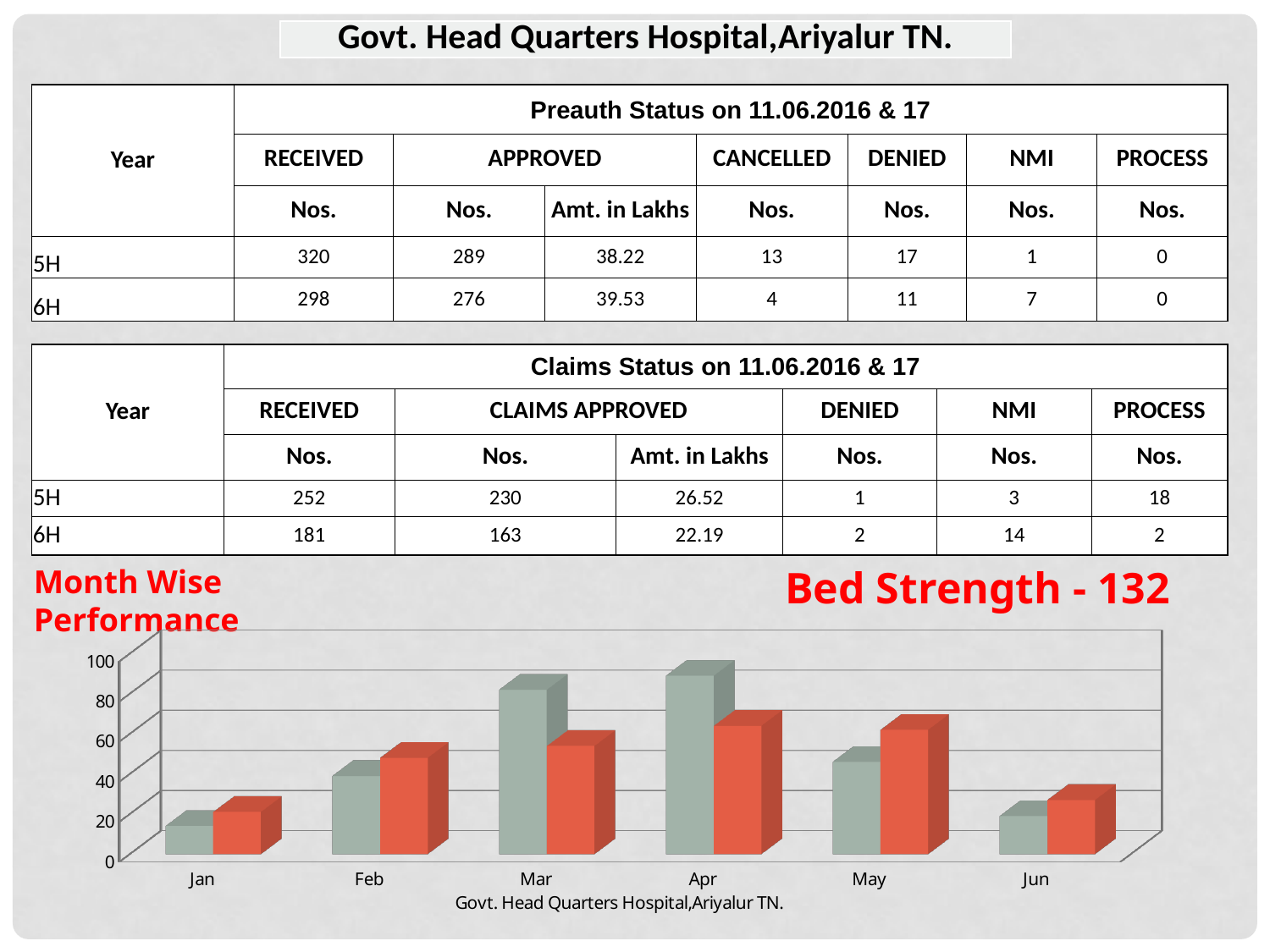
How many bars are plotted for each month in the Month Wise Performance chart? 2 In the Month Wise Performance chart, which is larger for May, the grey bar or the red bar? The red bar In the Month Wise Performance chart, which is larger for Mar, the grey bar or the red bar? The grey bar How many months are shown on the x axis of the Month Wise Performance chart? 6 In the Month Wise Performance chart, which month has the tallest grey bar? Apr In the Month Wise Performance chart, is the grey bar for Mar greater or less than 60? greater In the Month Wise Performance chart, is the red bar for Jan greater or less than 40? less In the Month Wise Performance chart, which month has the shortest grey bar? Jan What text appears as the label beneath the x axis of the Month Wise Performance chart? Govt. Head Quarters Hospital,Ariyalur TN. In the Month Wise Performance chart, is the grey bar for Jun greater or less than 40? less What kind of chart is shown at the bottom of the slide? Bar chart In the Month Wise Performance chart, do the grey bars rise or fall from Jan to Apr? Rise